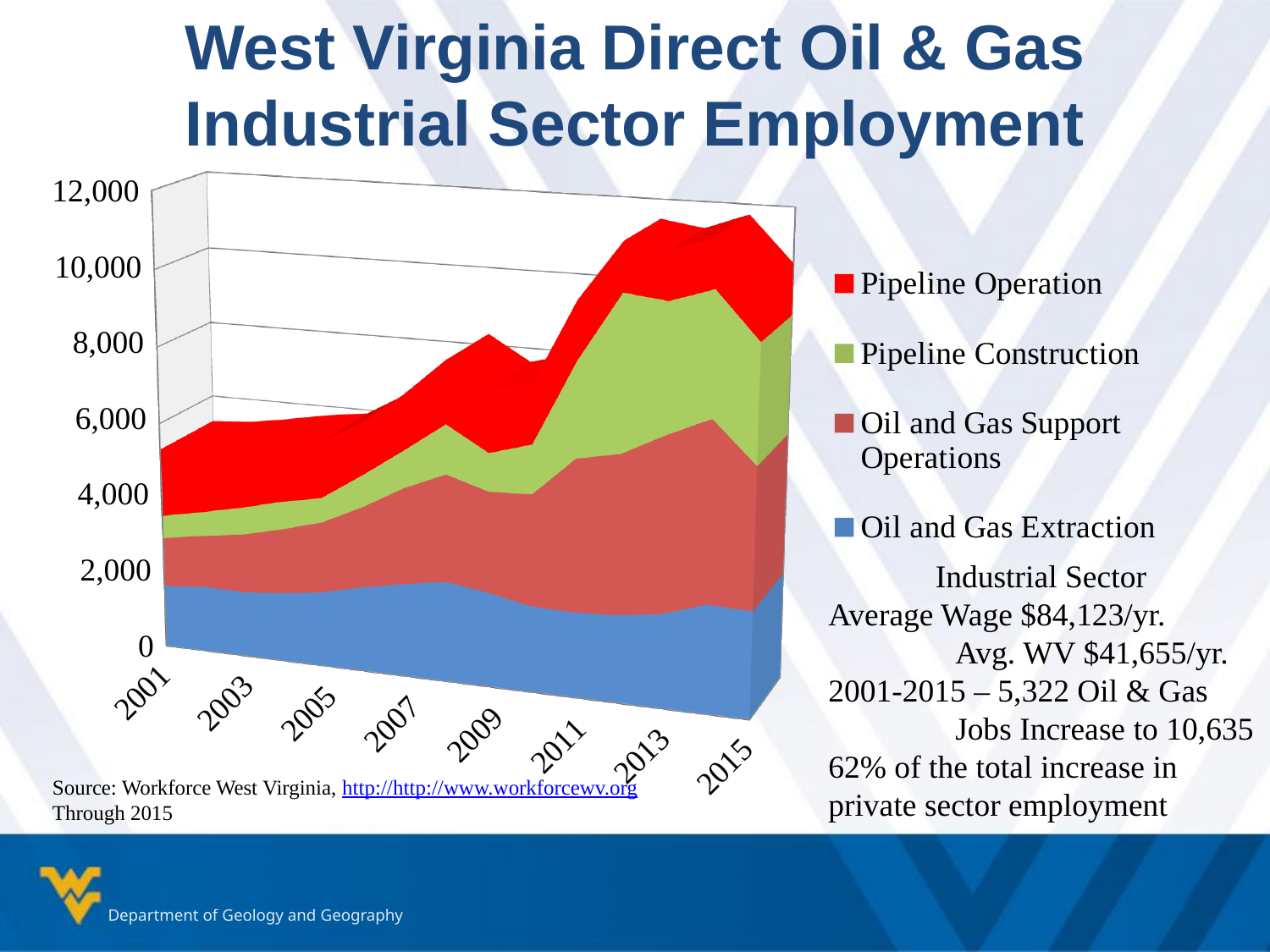
How many year labels are shown along the x axis of the chart? 8 How many series does the chart's legend list? 4 Is total employment larger in 2001 or in 2015? 2015 Which series is shown in red in the chart? Pipeline Operation Which year has the lowest total employment in the chart? 2001 Is the total employment in 2001 greater or less than 6,000? less Is the total employment in 2013 greater or less than 10,000? greater What kind of chart is shown on the slide? Stacked area chart Does total employment generally rise or fall from 2001 to 2013? rise Is the Oil and Gas Extraction value in 2001 greater or less than 2,000? less Which series is listed last in the chart's legend? Oil and Gas Extraction